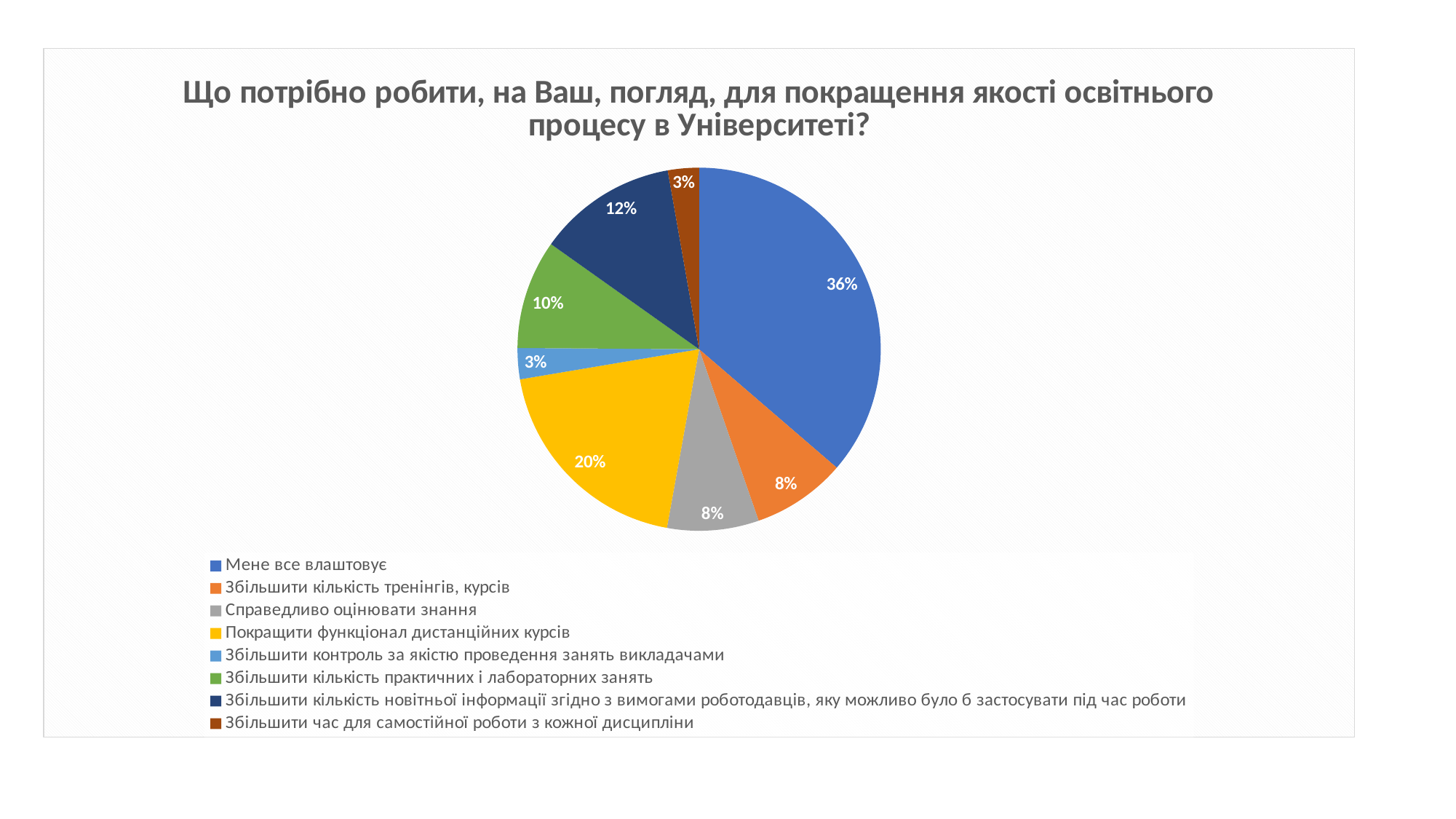
What is the value for "Покращити функціонал дистанційних курсів"? 20% What colour is the slice for "Покращити функціонал дистанційних курсів"? yellow What is the combined value of "Збільшити кількість тренінгів, курсів" and "Справедливо оцінювати знання"? 16% What is the value for "Збільшити час для самостійної роботи з кожної дисципліни"? 3% What kind of chart is shown on the slide? pie chart What is the difference between the values for "Мене все влаштовує" and "Покращити функціонал дистанційних курсів"? 16% Which category has the largest slice of the pie? Мене все влаштовує What is the value for "Збільшити кількість практичних і лабораторних занять"? 10% Which is larger: the value for "Збільшити кількість практичних і лабораторних занять" or the value for "Збільшити кількість тренінгів, курсів"? Збільшити кількість практичних і лабораторних занять What share of the pie does "Мене все влаштовує" take? 36% What is the value for "Збільшити кількість новітньої інформації згідно з вимогами роботодавців, яку можливо було б застосувати під час роботи"? 12% How many slices does the pie chart have? 8